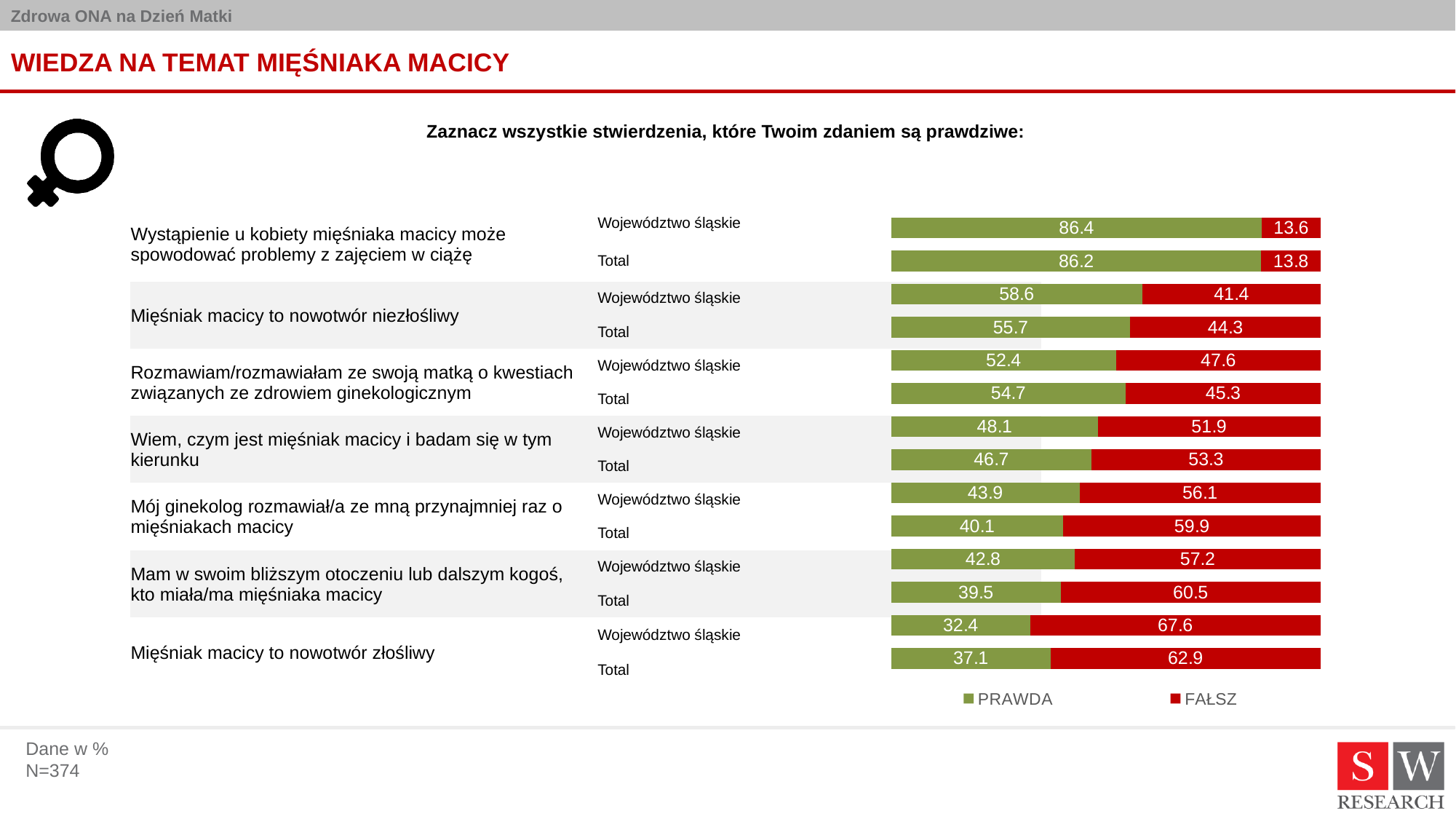
How many series does the legend list? 2 For the statement 'Mój ginekolog rozmawiał/a ze mną przynajmniej raz o mięśniakach macicy', which is larger: the PRAWDA value for 'Województwo śląskie' or for 'Total'? Województwo śląskie What is the PRAWDA value for 'Total' for the statement 'Mięśniak macicy to nowotwór niezłośliwy'? 55.7 Which statement has the highest PRAWDA value for 'Województwo śląskie'? Wystąpienie u kobiety mięśniaka macicy może spowodować problemy z zajęciem w ciążę What is the total of the stacked bar for 'Total' for the statement 'Wiem, czym jest mięśniak macicy i badam się w tym kierunku'? 100 How many bars are plotted in the chart? 14 What is the difference between the PRAWDA values for 'Województwo śląskie' and 'Total' for the statement 'Mięśniak macicy to nowotwór niezłośliwy'? 2.9 Which statement has the lowest PRAWDA value for 'Województwo śląskie'? Mięśniak macicy to nowotwór złośliwy What is the PRAWDA value for 'Województwo śląskie' for the statement 'Wystąpienie u kobiety mięśniaka macicy może spowodować problemy z zajęciem w ciążę'? 86.4 Which colour represents FAŁSZ in the chart? Red What kind of chart is shown on the slide? Stacked bar chart What is the FAŁSZ value for 'Total' for the statement 'Mięśniak macicy to nowotwór złośliwy'? 62.9